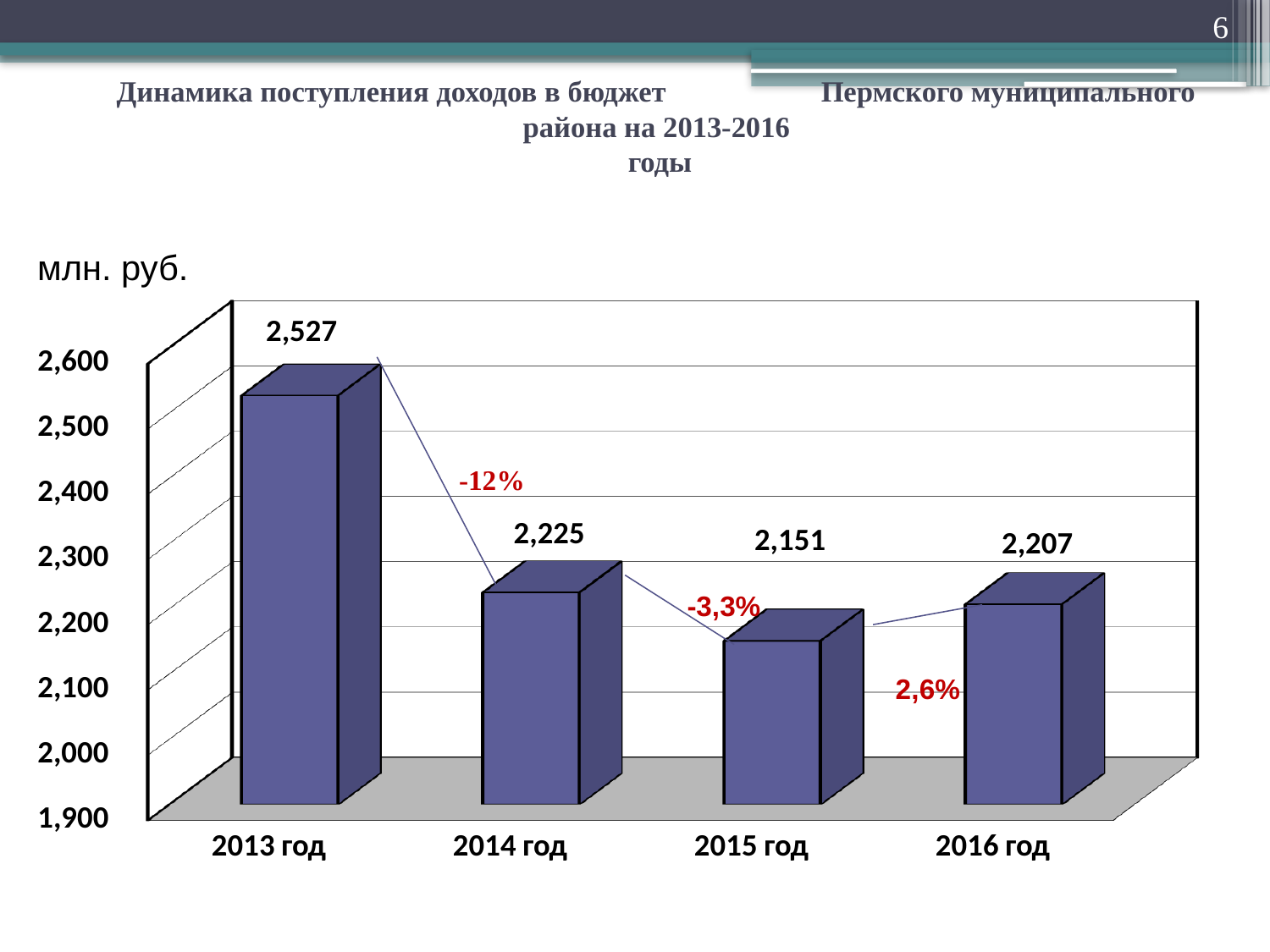
How many years are shown on the x axis? 4 What kind of chart is this? bar chart What is the difference between the values for 2013 год and 2014 год? 302 Is the value for 2015 год greater or less than 2,200? less Which year has the highest value? 2013 год What is the value for 2016 год? 2,207 What is the value for 2013 год? 2,527 Which year has the lowest value? 2015 год Which is larger, the value for 2014 год or the value for 2016 год? 2014 год What percentage change is labelled between 2013 год and 2014 год? -12% What is the difference between the values for 2016 год and 2015 год? 56 What is the value for 2015 год? 2,151